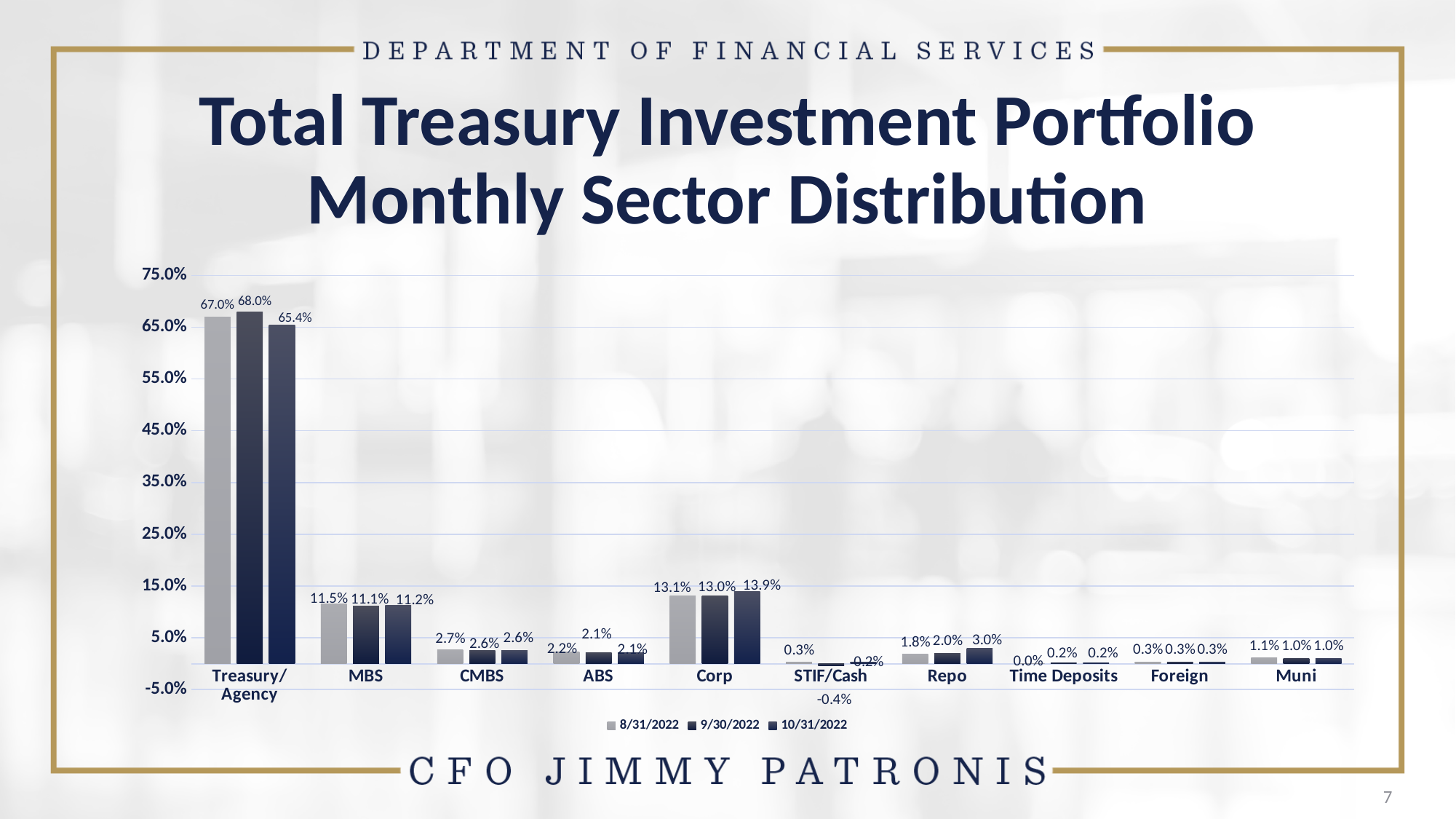
How many series does the legend list? 3 What is the value for Corp in the 10/31/2022 series? 13.9% What is the value for MBS in the 10/31/2022 series? 11.2% What is the value for Treasury/Agency in the 9/30/2022 series? 68.0% Which is larger for Corp: the 8/31/2022 value or the 10/31/2022 value? 10/31/2022 What kind of chart is shown on the slide? bar chart Which sector has the highest value in the 10/31/2022 series? Treasury/Agency Is the 8/31/2022 value for MBS greater or less than 15.0%? less What is the difference between the 10/31/2022 and 8/31/2022 values for Repo? 1.2% What is the value for Repo in the 8/31/2022 series? 1.8% What is the difference between the 9/30/2022 and 10/31/2022 values for Treasury/Agency? 2.6% How many sectors are shown on the x axis? 10